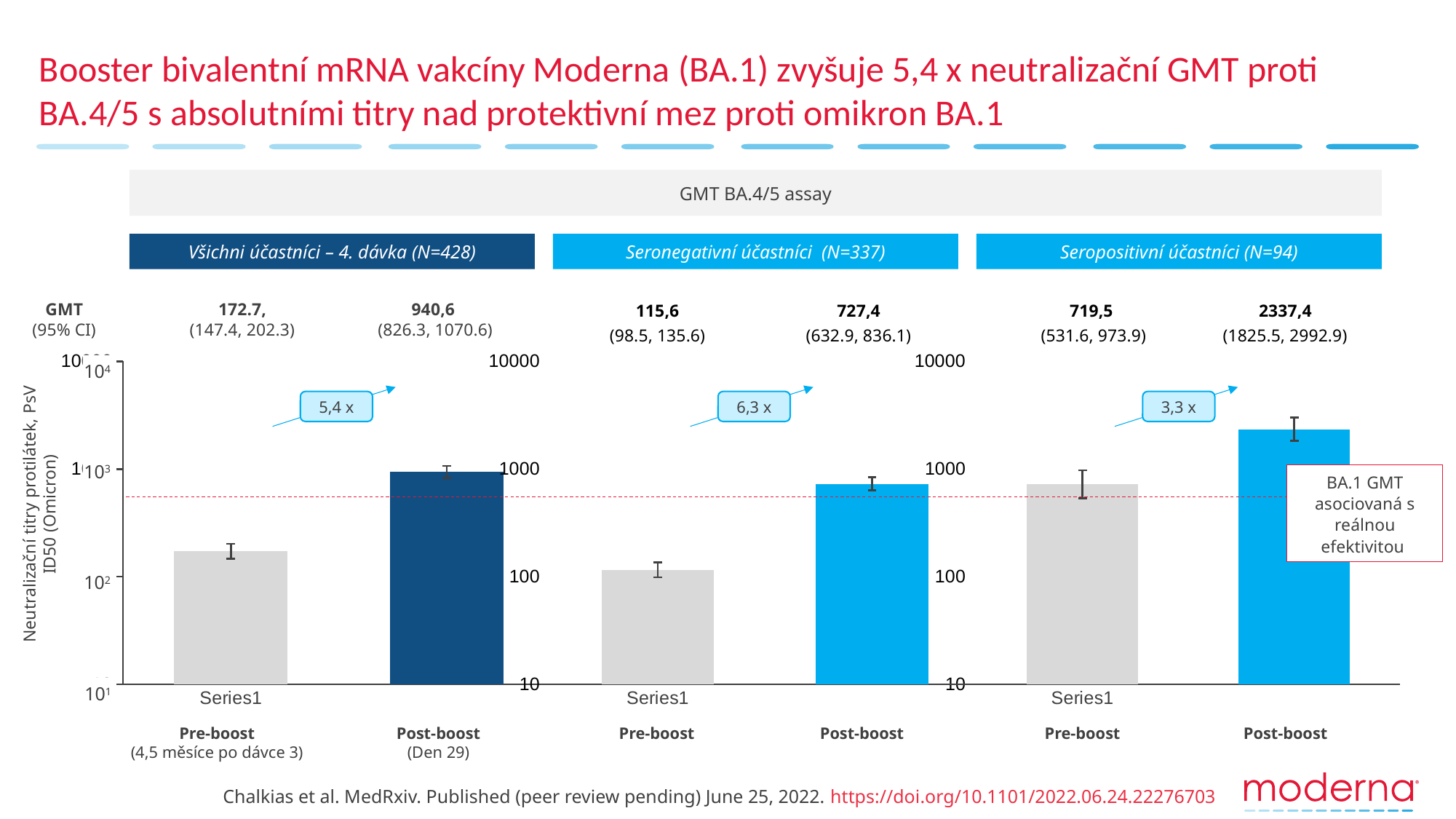
In the 'Seropositivní účastníci (N=94)' panel, is the Pre-boost bar greater or less than 1000? less In the 'Seronegativní účastníci (N=337)' panel, what is the GMT for Pre-boost? 115,6 Across all three panels, which bar has the highest GMT? Post-boost in Seropositivní účastníci (N=94) In the 'Všichni účastníci – 4. dávka (N=428)' panel, what is the GMT for Post-boost (Den 29)? 940,6 In the 'Seropositivní účastníci (N=94)' panel, what is the GMT for Post-boost? 2337,4 Across all three panels, which bar has the lowest GMT? Pre-boost in Seronegativní účastníci (N=337) What kind of chart is used on this slide? bar chart In the 'Všichni účastníci – 4. dávka (N=428)' panel, what is the 95% CI shown for the Pre-boost GMT? (147.4, 202.3) Which is larger: the Post-boost GMT for Seronegativní účastníci or the Pre-boost GMT for Seropositivní účastníci? Post-boost GMT for Seronegativní účastníci In the 'Seropositivní účastníci (N=94)' panel, what is the difference between the Post-boost and Pre-boost GMT? 1617,9 What fold increase is shown in the 'Seronegativní účastníci (N=337)' panel? 6,3 x In the 'Seronegativní účastníci (N=337)' panel, what is the difference between the Post-boost and Pre-boost GMT? 611,8